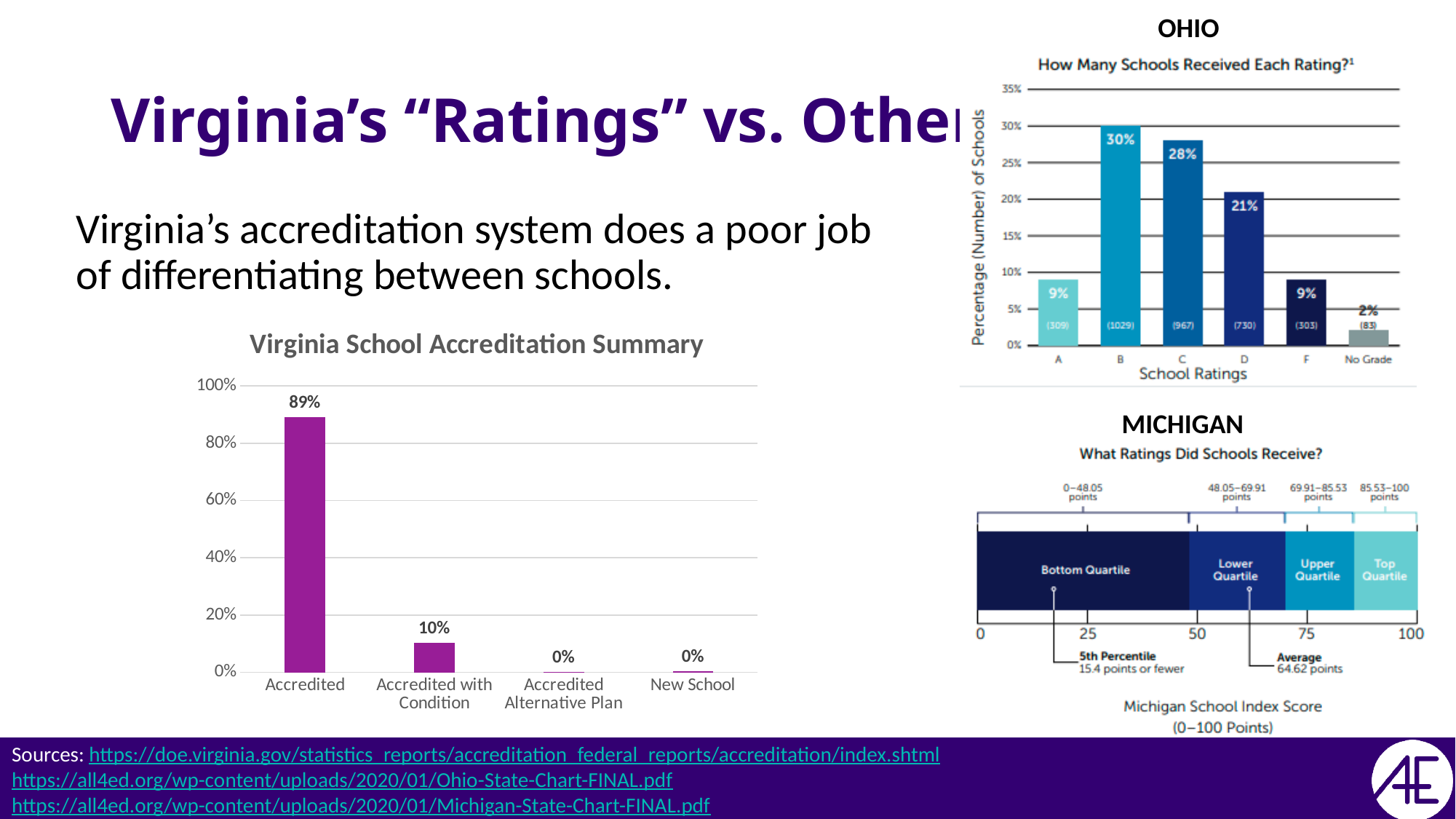
In the Ohio chart, how many schools received a C rating (the number in parentheses)? 967 How many school rating categories are shown on the x axis of the Ohio chart? 6 In the Virginia School Accreditation Summary chart, which category has the highest value? Accredited In the Ohio chart, which is larger, the percentage for rating C or rating D? C How many categories are shown on the x axis of the Virginia School Accreditation Summary chart? 4 In the Virginia School Accreditation Summary chart, what is the difference between the Accredited and Accredited with Condition values? 79% In the Ohio chart, what percentage of schools received a B rating? 30% In the Virginia School Accreditation Summary chart, what is the value for Accredited with Condition? 10% In the Virginia School Accreditation Summary chart, what percentage of schools are Accredited? 89% In the Michigan chart, what is the average Michigan School Index Score shown? 64.62 points In the Ohio chart, which school rating has the lowest percentage of schools? No Grade What kind of chart is the Virginia School Accreditation Summary? Bar chart